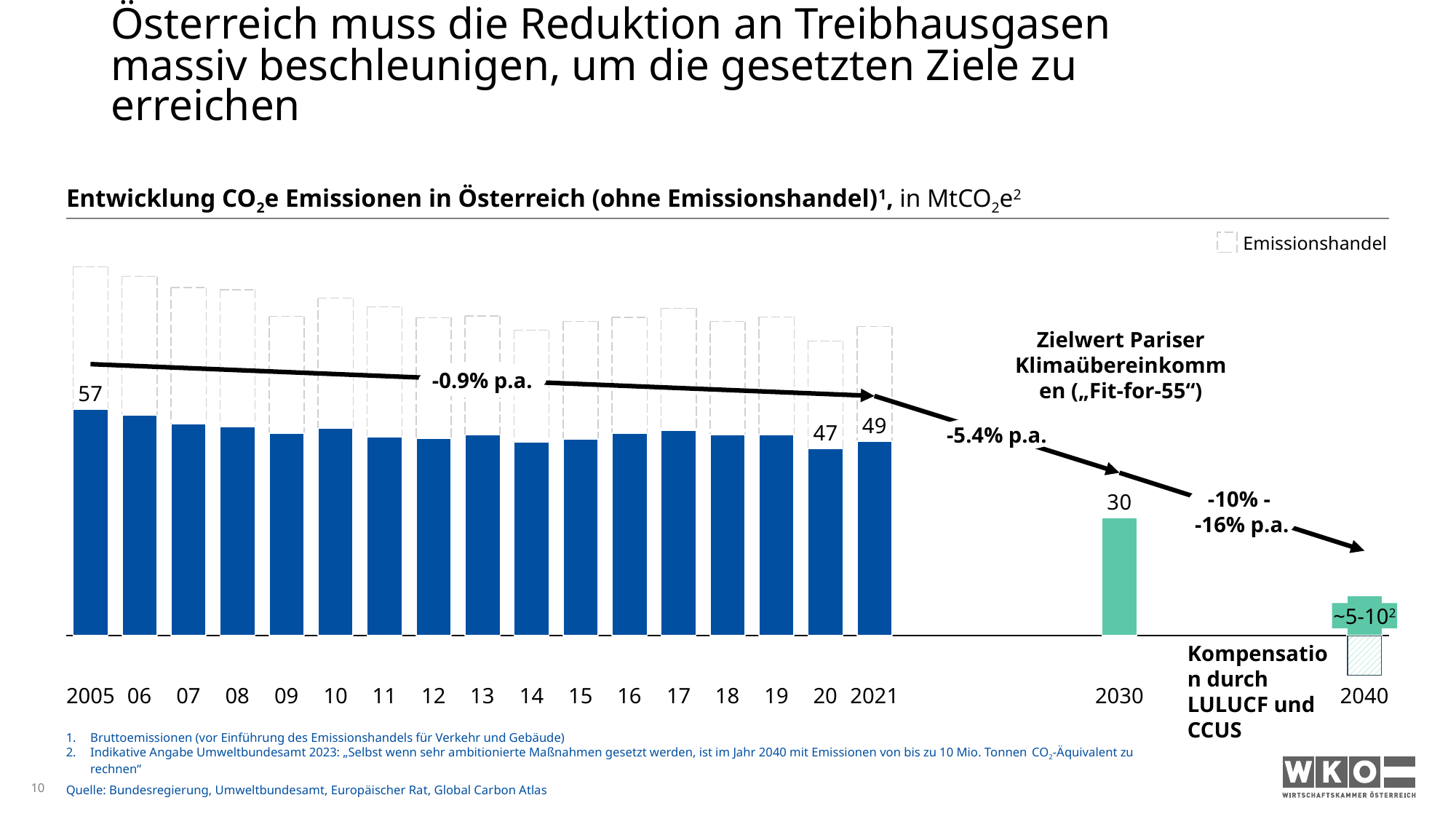
Which year has the highest emissions value? 2005 What is the value for 2005? 57 What is the value for 2021? 49 What kind of chart is shown on the slide? bar chart What annual rate of change is annotated for the period 2005 to 2021? -0.9% p.a. What is the target value shown for 2030? 30 What is the difference between the values for 2005 and 2021? 8 What is the value for 2020? 47 Do the values rise or fall from 2005 to 2021? fall How many years from 2005 to 2021 are plotted as bars? 17 What is the difference between the values for 2021 and 2030? 19 Which is larger, the value for 2020 or the value for 2021? 2021